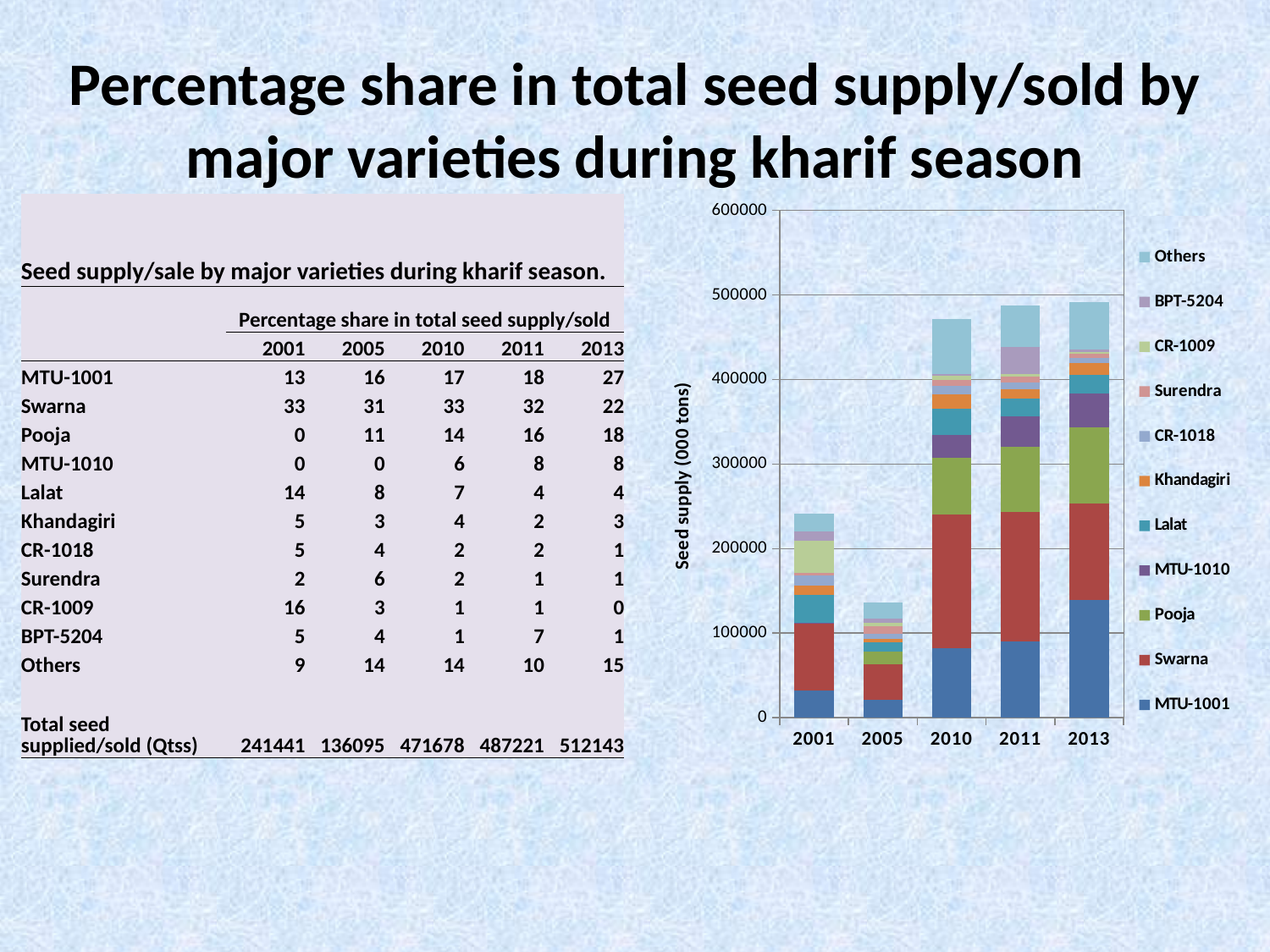
Which year has a larger total bar, 2001 or 2005? 2001 What is the title of the chart's vertical axis? Seed supply (000 tons) Which year has the lowest total seed supply in the chart? 2005 Which year has the highest total seed supply in the chart? 2013 How many series does the chart's legend list? 11 Do the total bars rise or fall from 2005 to 2013? rise How many years are shown on the x axis of the chart? 5 Is the total bar for 2011 greater or less than 500000? less Is the total bar for 2001 greater or less than 200000? greater What kind of chart is shown on the slide? stacked bar chart Is the total bar for 2010 greater or less than 400000? greater